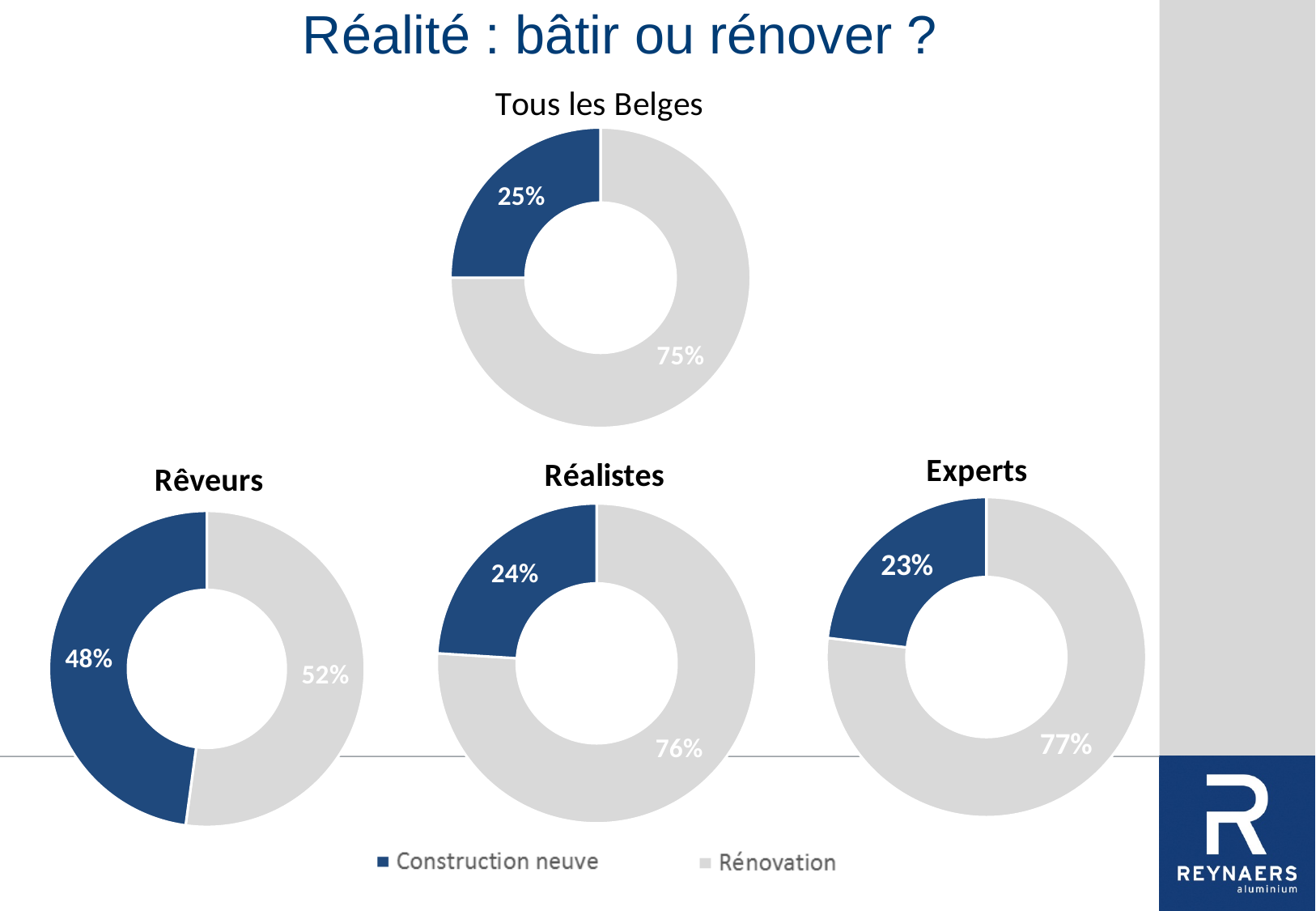
In the 'Réalistes' chart, what percentage is shown for Rénovation? 76% In the 'Experts' chart, what percentage is shown for Construction neuve? 23% In the 'Réalistes' chart, what is the difference between the Rénovation and Construction neuve percentages? 52% In the 'Rêveurs' chart, which slice is larger, Construction neuve or Rénovation? Rénovation In the 'Rêveurs' chart, what is the difference between the Rénovation and Construction neuve percentages? 4% In the 'Experts' chart, what percentage is shown for Rénovation? 77% What kind of chart is used for the 'Experts' chart? Doughnut (pie) chart How many entries does the legend at the bottom of the slide list? 2 In the 'Tous les Belges' chart, what percentage is shown for Rénovation? 75% How many slices does the 'Réalistes' chart have? 2 In the 'Rêveurs' chart, what percentage is shown for Construction neuve? 48% In the 'Tous les Belges' chart, what percentage is shown for Construction neuve? 25%